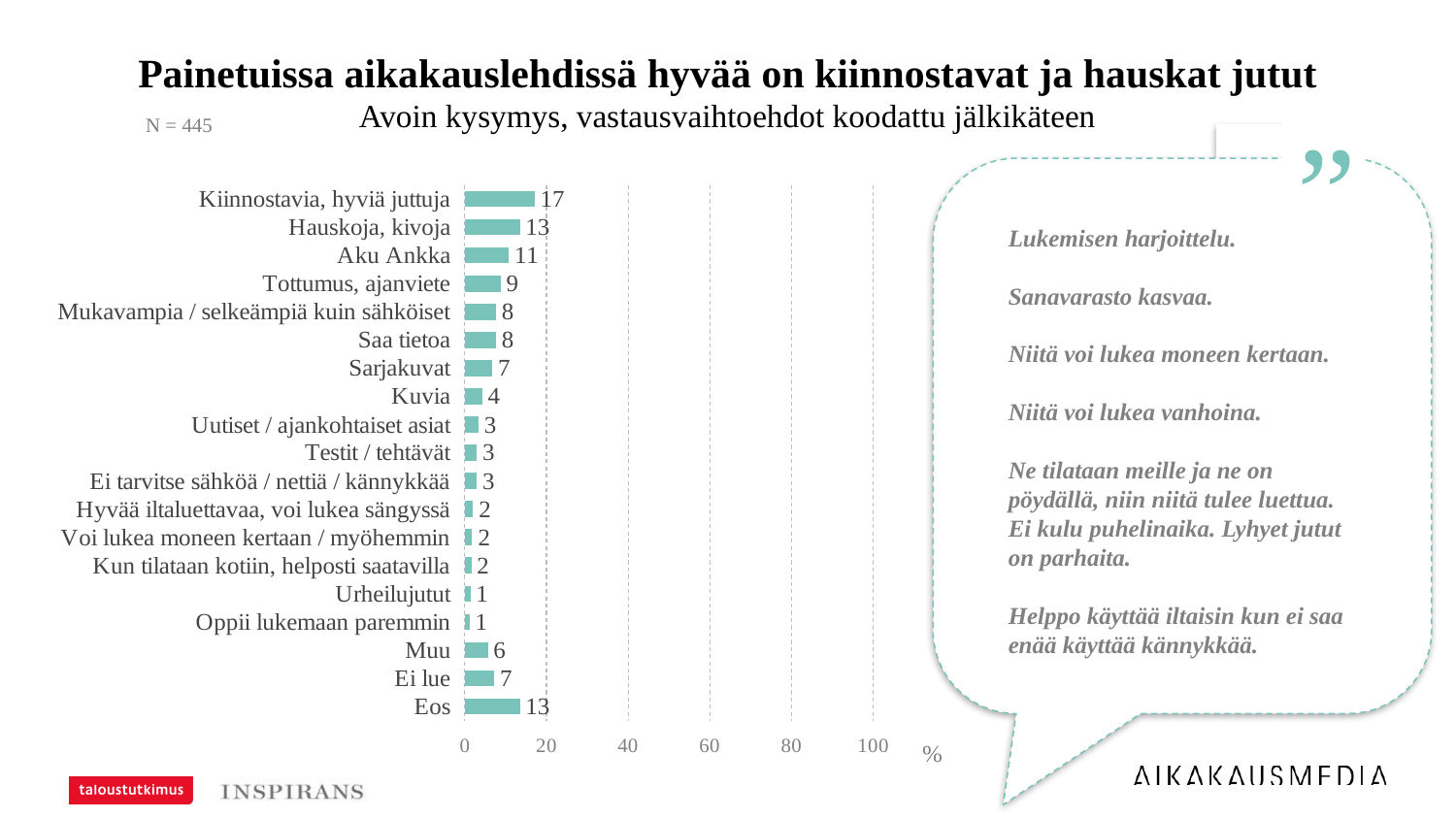
What is the value for "Muu"? 6 What is the value for "Eos"? 13 Which category has the highest value? Kiinnostavia, hyviä juttuja What kind of chart is shown on the slide? bar chart What is the value for "Sarjakuvat"? 7 Is the value for "Kiinnostavia, hyviä juttuja" greater or less than 20? less How many categories are shown in the chart? 19 What is the value for "Kiinnostavia, hyviä juttuja"? 17 What is the difference between the values for "Kiinnostavia, hyviä juttuja" and "Hauskoja, kivoja"? 4 What is the value for "Aku Ankka"? 11 What unit is shown on the x axis of the chart? % Which is larger, the value for "Tottumus, ajanviete" or the value for "Kuvia"? Tottumus, ajanviete